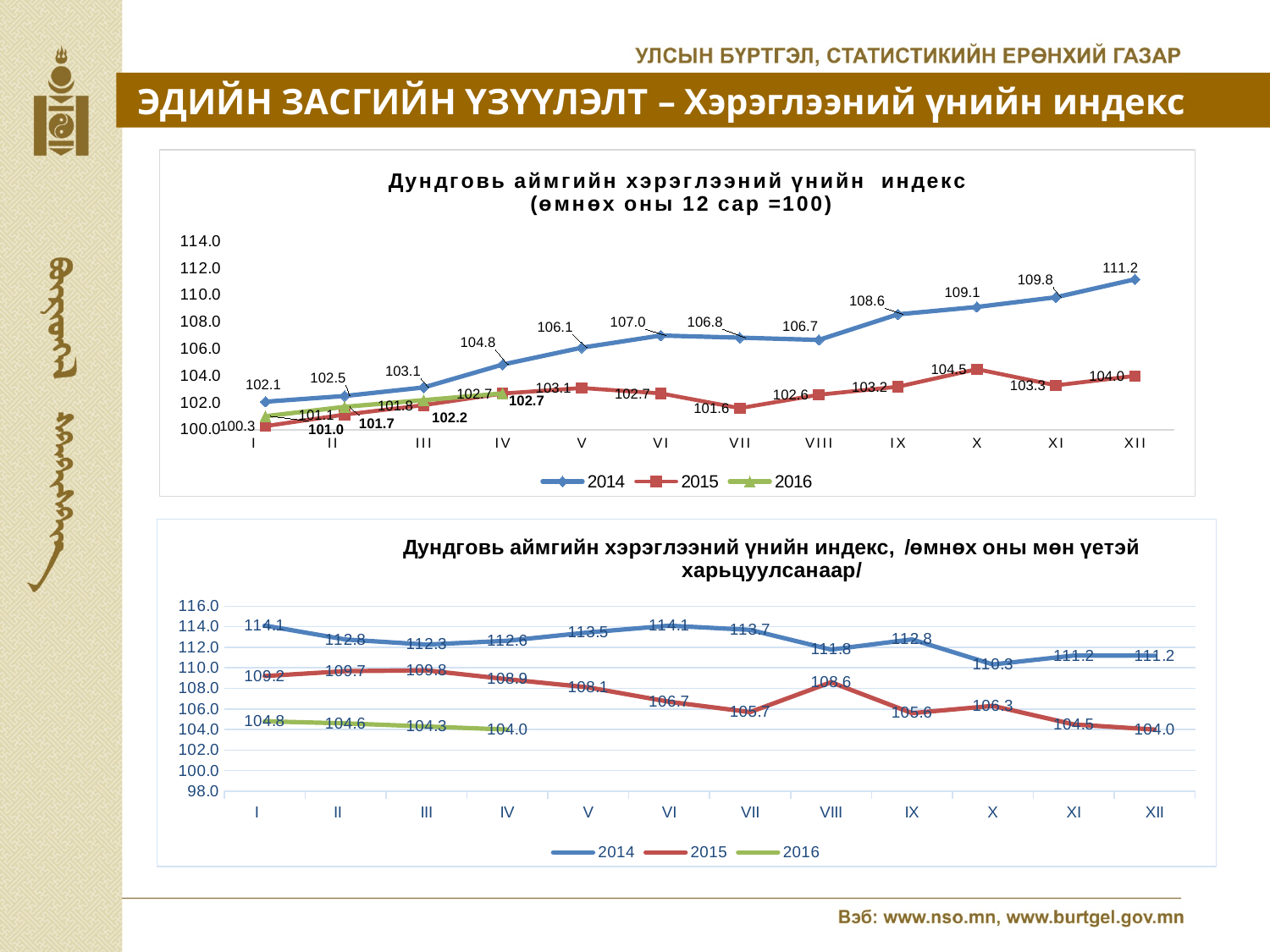
In the bottom chart (өмнөх оны мөн үетэй харьцуулсанаар), in which month is the 2014 value lowest? X In the bottom chart (өмнөх оны мөн үетэй харьцуулсанаар), which is larger: the 2014 value for month VI or the 2014 value for month VIII? month VI In the top chart (өмнөх оны 12 сар =100), what is the 2015 value for month X? 104.5 In the top chart (өмнөх оны 12 сар =100), in which month does the 2014 series reach its highest value? XII What type of chart is the bottom chart? line chart In the bottom chart (өмнөх оны мөн үетэй харьцуулсанаар), what is the 2016 value for month IV? 104.0 In the bottom chart (өмнөх оны мөн үетэй харьцуулсанаар), what is the 2015 value for month VIII? 108.6 In the top chart (өмнөх оны 12 сар =100), how many series does the legend list? 3 In the top chart (өмнөх оны 12 сар =100), what is the 2014 value for month XII? 111.2 In the top chart (өмнөх оны 12 сар =100), what is the 2014 value for month IX? 108.6 In the top chart (өмнөх оны 12 сар =100), what is the difference between the 2014 and 2015 values for month XII? 7.2 In the bottom chart (өмнөх оны мөн үетэй харьцуулсанаар), does the 2016 series rise or fall from month I to month IV? fall